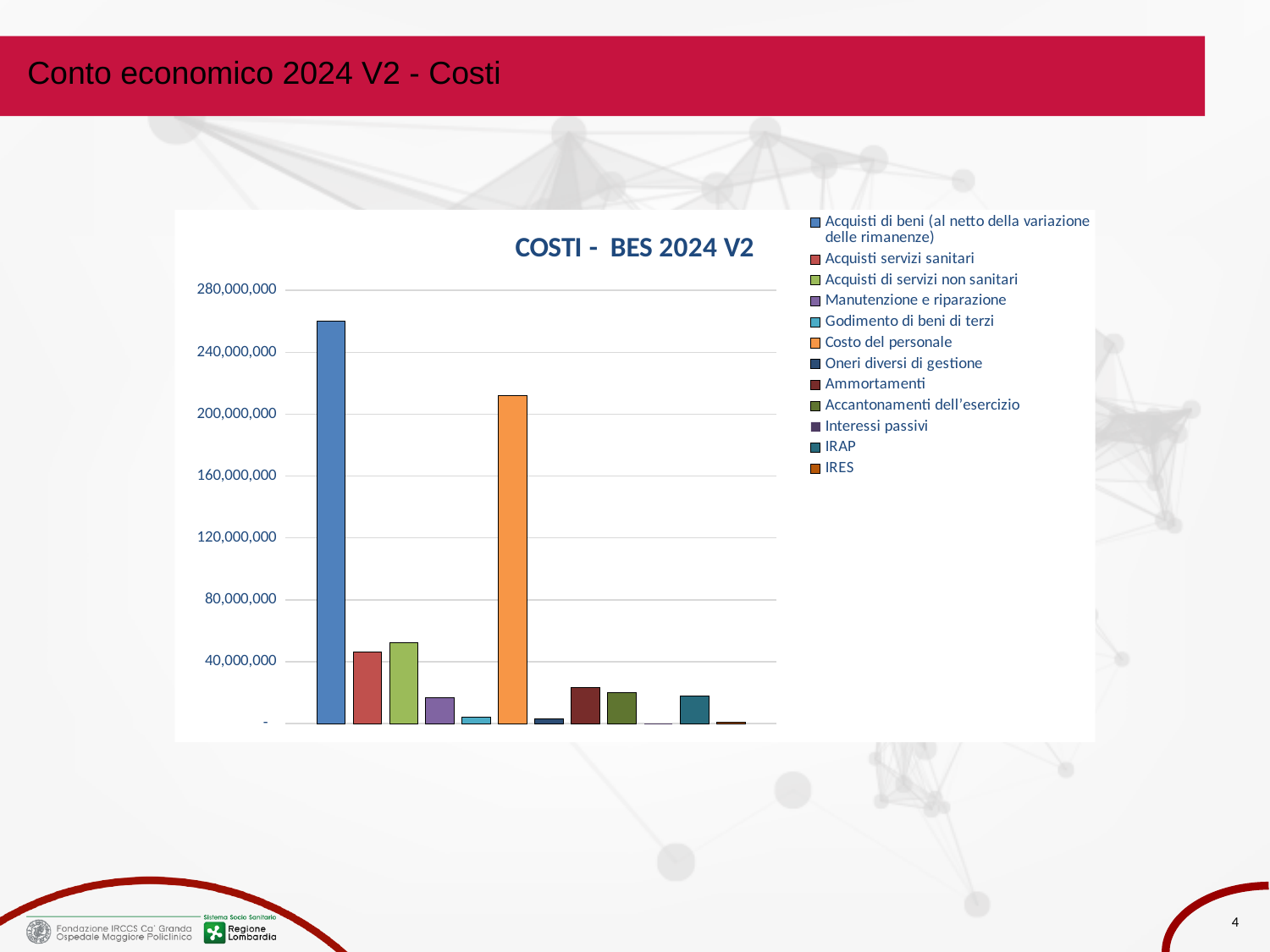
What is the title of the chart? COSTI - BES 2024 V2 How many bars are plotted in the chart? 12 What kind of chart is shown on the slide? bar chart Is the value for Acquisti servizi sanitari greater or less than 40,000,000? greater Is the value for Manutenzione e riparazione greater or less than 40,000,000? less Which cost category has the highest bar? Acquisti di beni (al netto della variazione delle rimanenze) Which is larger, Ammortamenti or Godimento di beni di terzi? Ammortamenti Is the value for Costo del personale greater or less than 200,000,000? greater Which is larger, Costo del personale or Acquisti di beni (al netto della variazione delle rimanenze)? Acquisti di beni (al netto della variazione delle rimanenze) Which series is shown in orange in the legend? Costo del personale How many series does the legend list? 12